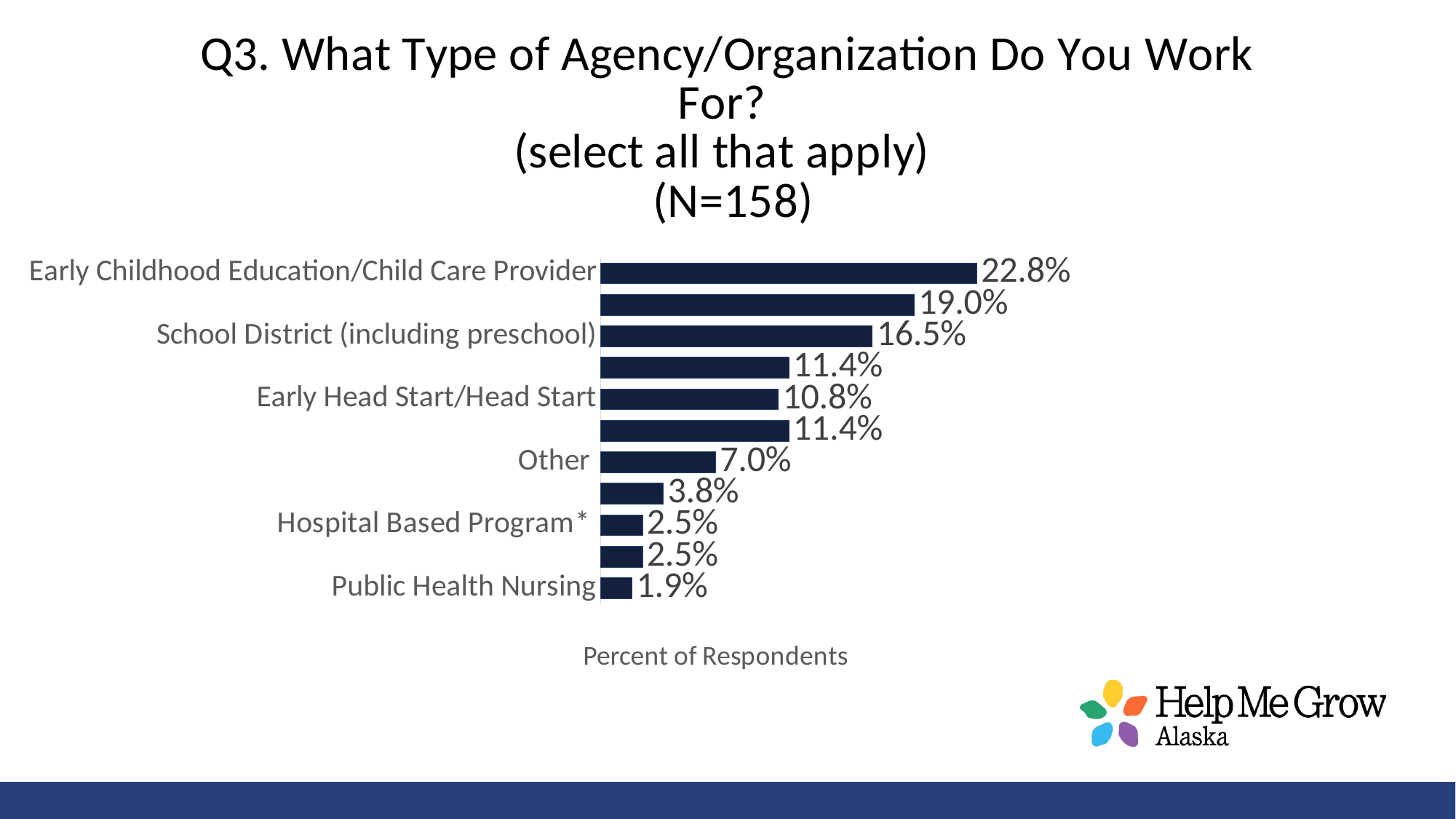
Which is larger: the value for Other or the value for Early Head Start/Head Start? Early Head Start/Head Start What is the value shown for School District (including preschool)? 16.5% How many bars are plotted in the chart? 11 Which agency/organization type has the highest percentage of respondents? Early Childhood Education/Child Care Provider What percentage of respondents work for Early Head Start/Head Start? 10.8% What percentage of respondents work for an Early Childhood Education/Child Care Provider? 22.8% What kind of chart is shown on the slide? Bar chart What is the value for Hospital Based Program*? 2.5% What is the difference in percentage points between Early Childhood Education/Child Care Provider and School District (including preschool)? 6.3 What is the label on the horizontal axis of the chart? Percent of Respondents What is the value for Public Health Nursing? 1.9% Which labeled agency/organization type has the lowest percentage of respondents? Public Health Nursing